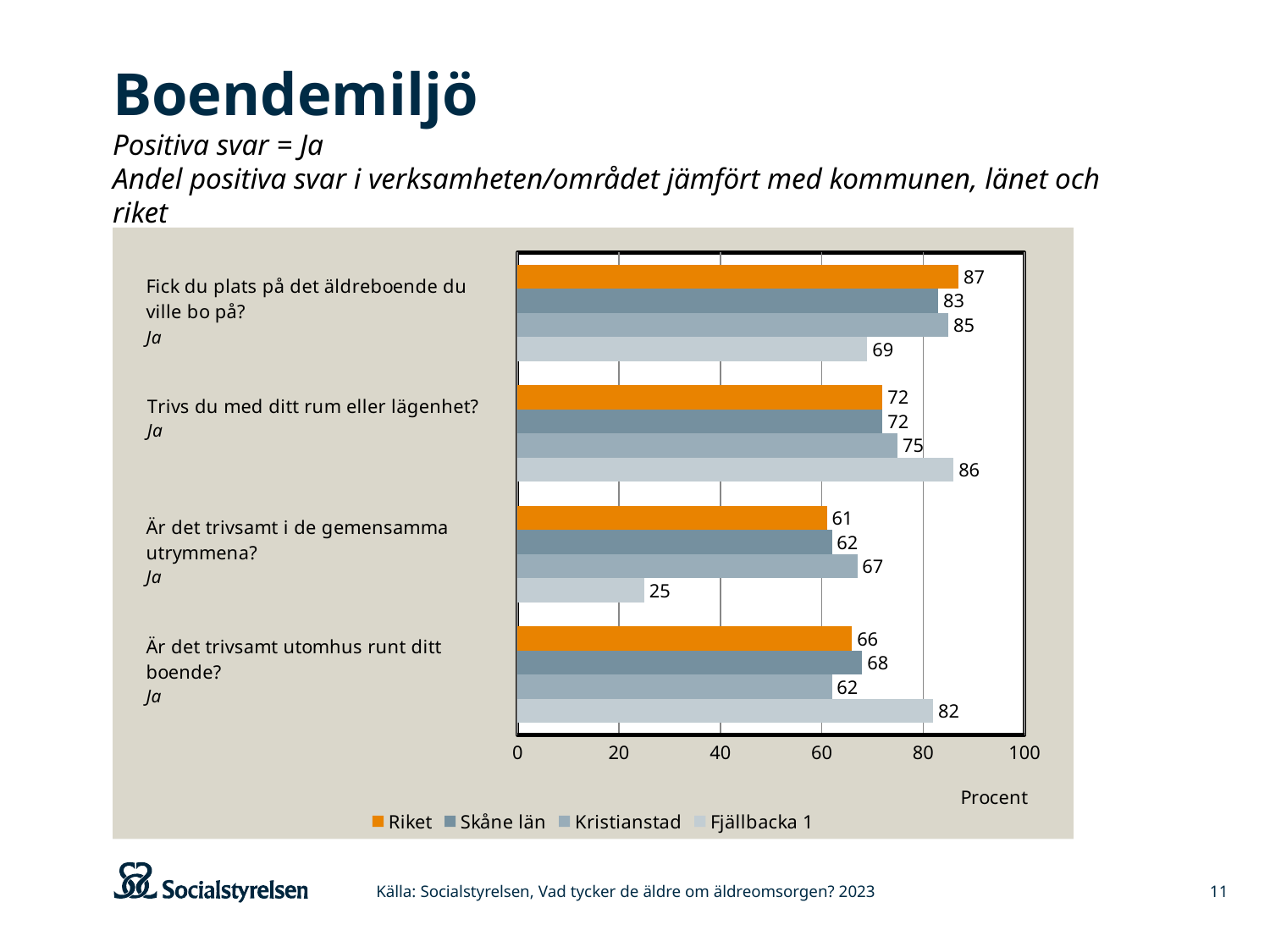
Which is larger on "Är det trivsamt utomhus runt ditt boende?": Skåne län or Kristianstad? Skåne län Which series has the highest value on "Är det trivsamt utomhus runt ditt boende?"? Fjällbacka 1 Which series has the lowest value on "Är det trivsamt i de gemensamma utrymmena?"? Fjällbacka 1 How many series does the legend list? 4 What is the value for Riket on "Fick du plats på det äldreboende du ville bo på?"? 87 What is the value for Fjällbacka 1 on "Trivs du med ditt rum eller lägenhet?"? 86 What kind of chart is shown on the slide? bar chart What is the value for Kristianstad on "Är det trivsamt i de gemensamma utrymmena?"? 67 Is the value for Fjällbacka 1 on "Är det trivsamt i de gemensamma utrymmena?" greater or less than 40? less How many questions (categories) are shown in the chart? 4 What unit is shown on the x axis of the chart? Procent What is the difference between Kristianstad and Fjällbacka 1 on "Fick du plats på det äldreboende du ville bo på?"? 16